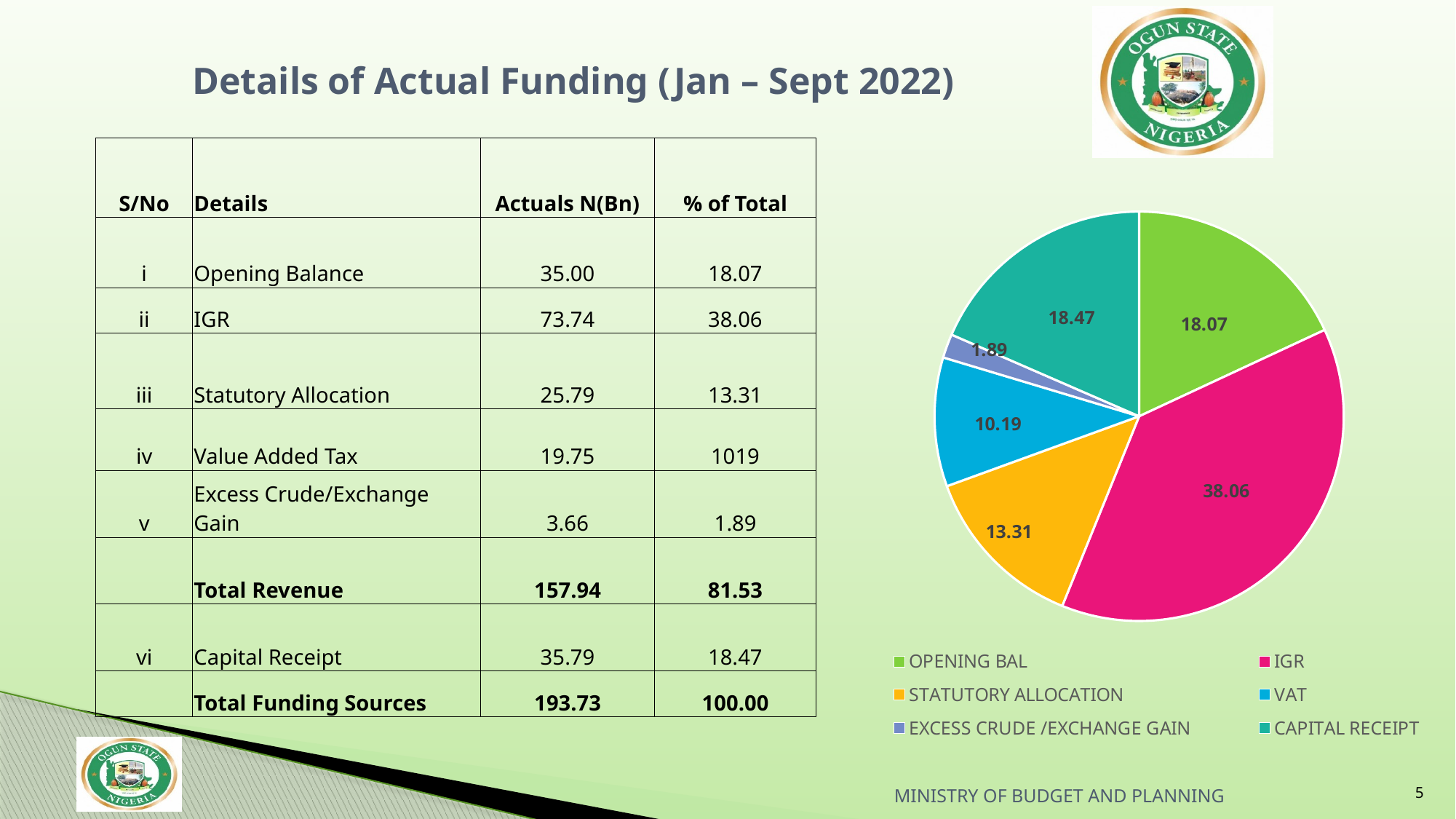
In the pie chart, which is larger: OPENING BAL or VAT? OPENING BAL How many entries does the pie chart legend list? 6 How many slices does the pie chart have? 6 What is the value shown for the VAT slice of the pie chart? 10.19 What is the difference between the IGR value and the STATUTORY ALLOCATION value in the pie chart? 24.75 What type of chart is shown on the slide? pie chart Which category has the largest slice in the pie chart? IGR Which category has the smallest slice in the pie chart? EXCESS CRUDE /EXCHANGE GAIN What colour is the IGR slice in the pie chart? pink/magenta What is the value shown for the CAPITAL RECEIPT slice of the pie chart? 18.47 What is the value shown for the EXCESS CRUDE /EXCHANGE GAIN slice of the pie chart? 1.89 What is the value shown for the IGR slice of the pie chart? 38.06